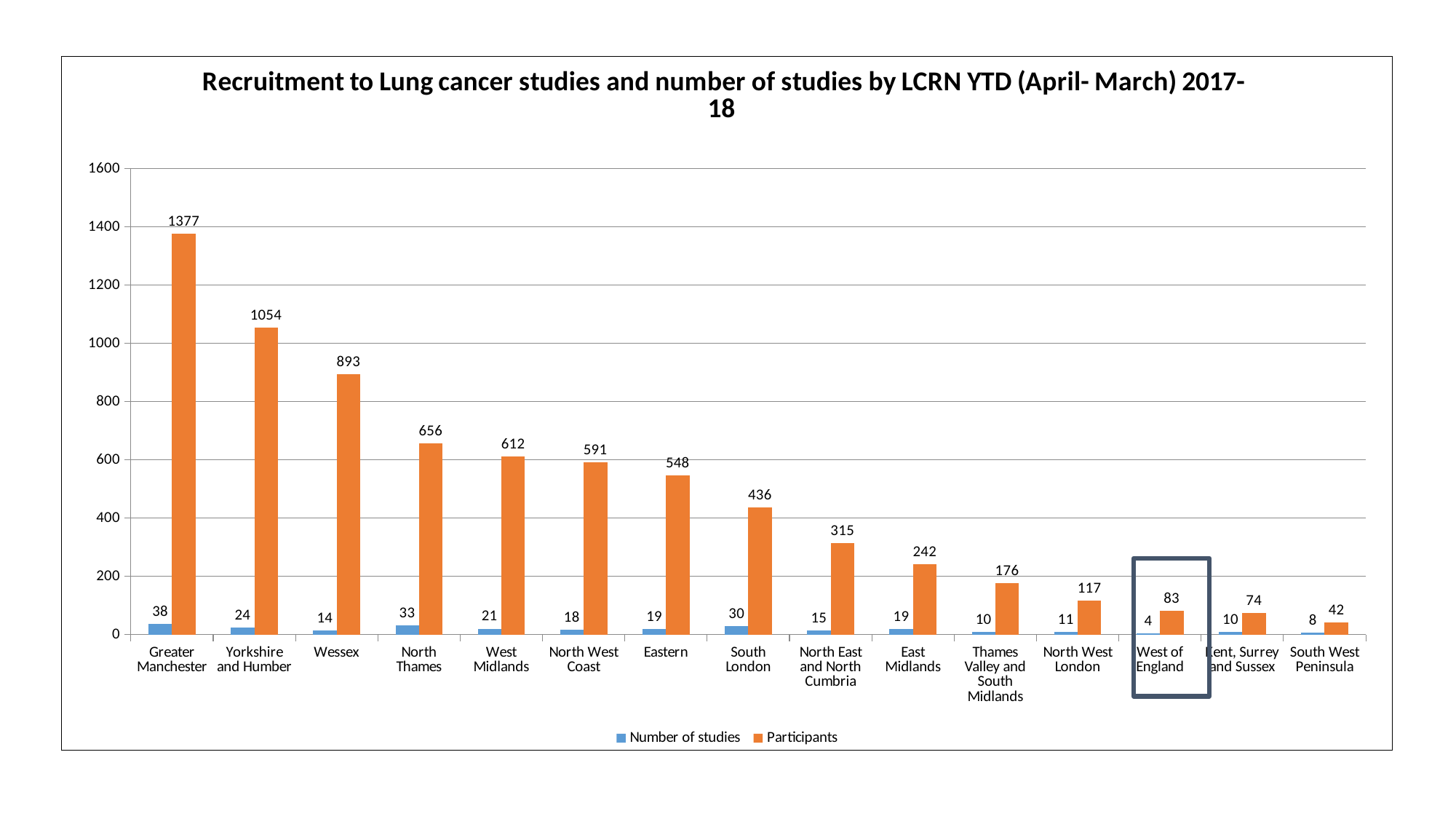
How many LCRNs are shown on the x axis? 15 What kind of chart is shown on the slide? Bar chart How many series does the legend list? 2 Is the number of participants for North East and North Cumbria greater or less than 400? less Which has more participants, Eastern or South London? Eastern What is the difference in participants between Yorkshire and Humber and Wessex? 161 How many participants were recruited in Greater Manchester? 1377 What is the number of studies for North Thames? 33 Which LCRN has the lowest number of studies? West of England How many participants were recruited in West of England? 83 Which LCRN has the lowest number of participants? South West Peninsula Which LCRN has the highest number of participants? Greater Manchester